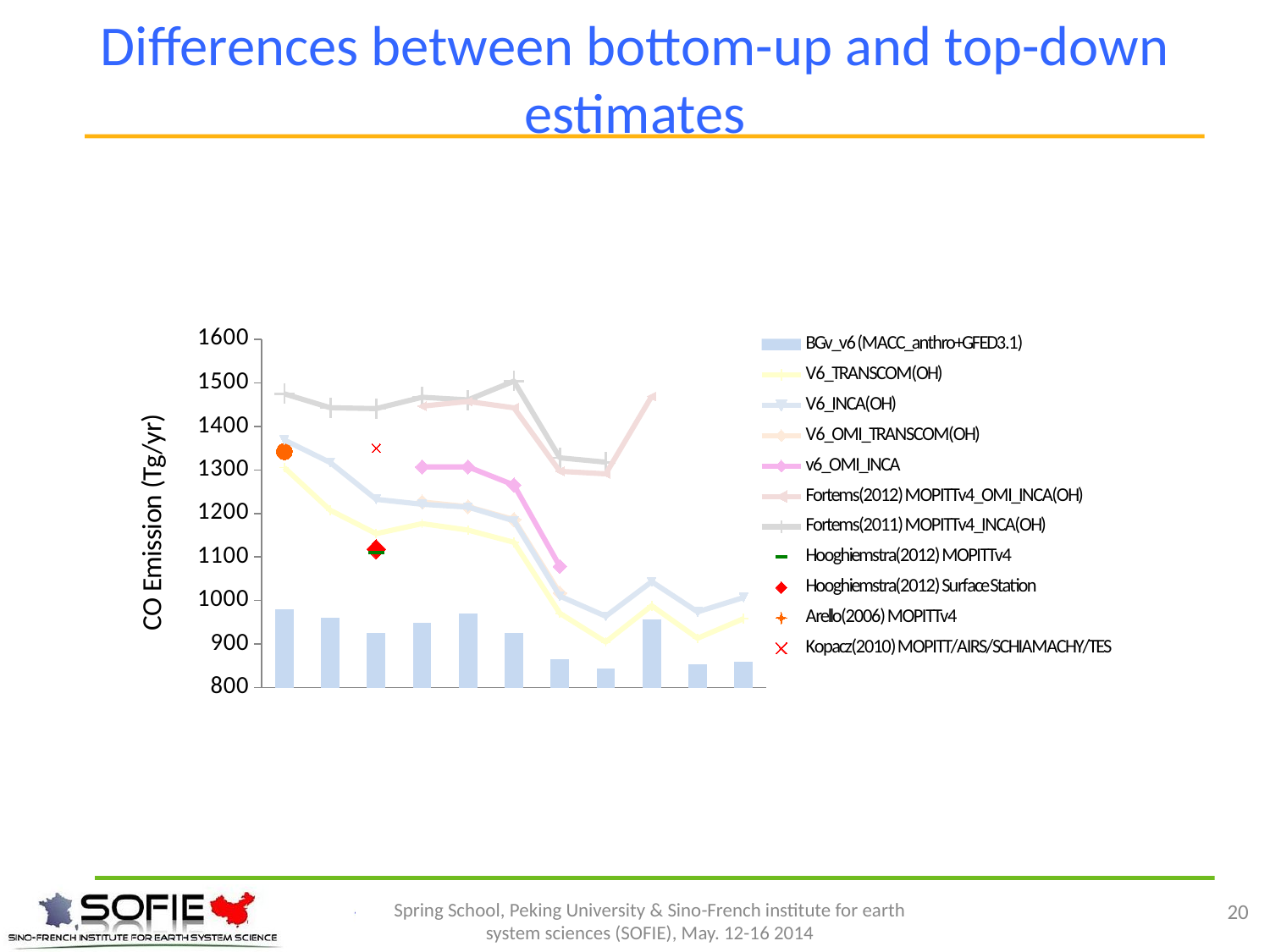
Are the BGv_v6 (MACC_anthro+GFED3.1) bar values greater or less than 1000 Tg/yr? less How many series does the chart's legend list? 11 Is the first point of the Fortems(2011) MOPITTv4_INCA(OH) line greater or less than 1400? greater What is the y-axis label of the chart? CO Emission (Tg/yr) Does the v6_OMI_INCA line rise or fall from left to right? fall Is the Hooghiemstra(2012) Surface Station point greater or less than 1200? less What is the maximum value shown on the y axis? 1600 Which line series lies highest on the chart across most of the x axis? Fortems(2011) MOPITTv4_INCA(OH) Which series in the chart is drawn as bars? BGv_v6 (MACC_anthro+GFED3.1) Which line series lies lowest on the chart across the x axis? V6_TRANSCOM(OH)